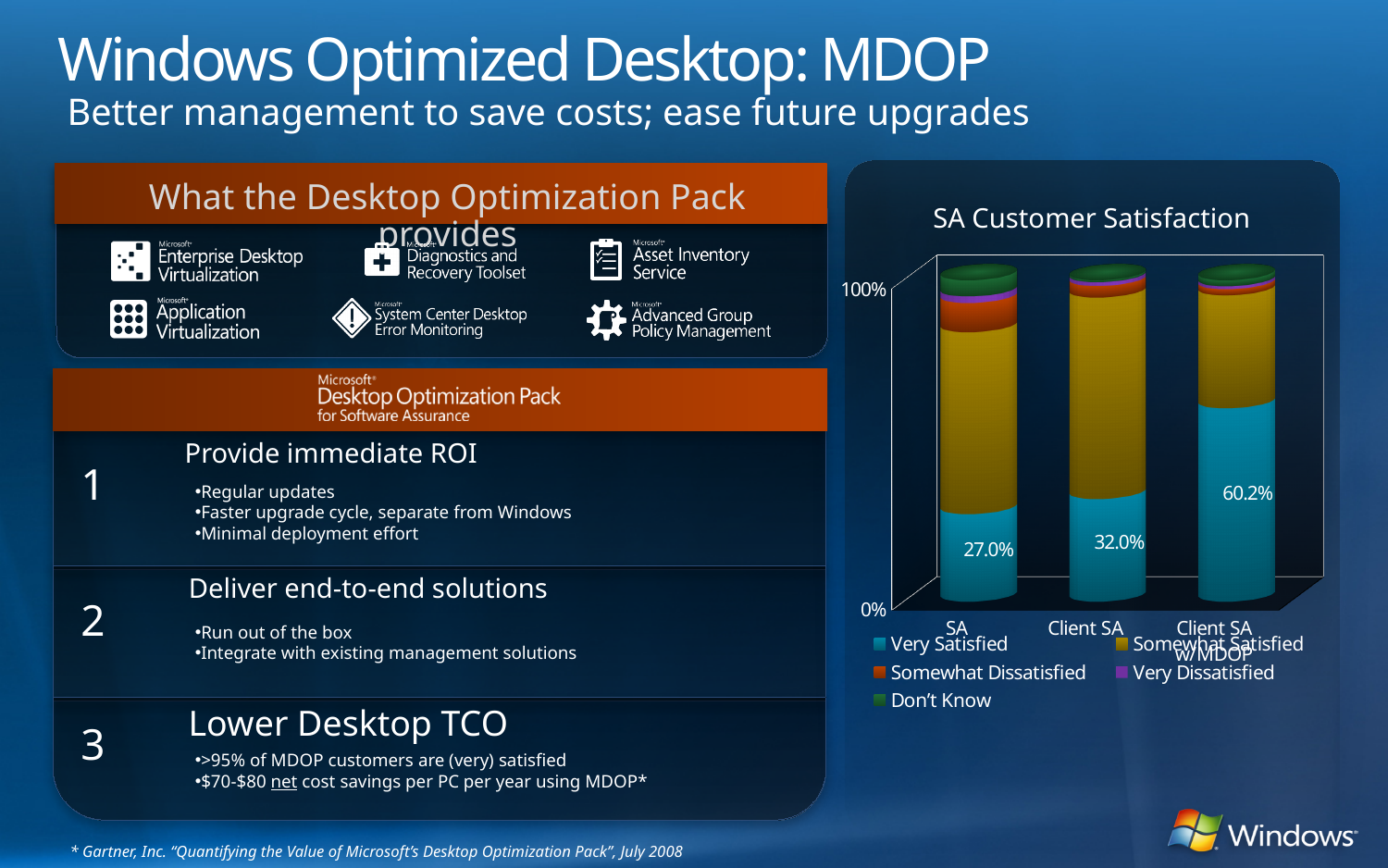
What is the difference in Very Satisfied percentage between Client SA and SA? 5.0% Which category has the highest Very Satisfied percentage? Client SA w/MDOP What is the Very Satisfied percentage for Client SA? 32.0% How many categories are shown on the x axis of the SA Customer Satisfaction chart? 3 How many series does the legend of the SA Customer Satisfaction chart list? 5 Which has a larger Very Satisfied percentage, Client SA or Client SA w/MDOP? Client SA w/MDOP What is the Very Satisfied percentage for Client SA w/MDOP? 60.2% Does the Very Satisfied percentage rise or fall moving from SA to Client SA w/MDOP along the x axis? Rise Which category has the lowest Very Satisfied percentage? SA What is the difference in Very Satisfied percentage between Client SA w/MDOP and SA? 33.2% What kind of chart is the SA Customer Satisfaction chart? Stacked bar chart What is the Very Satisfied percentage for the SA category? 27.0%